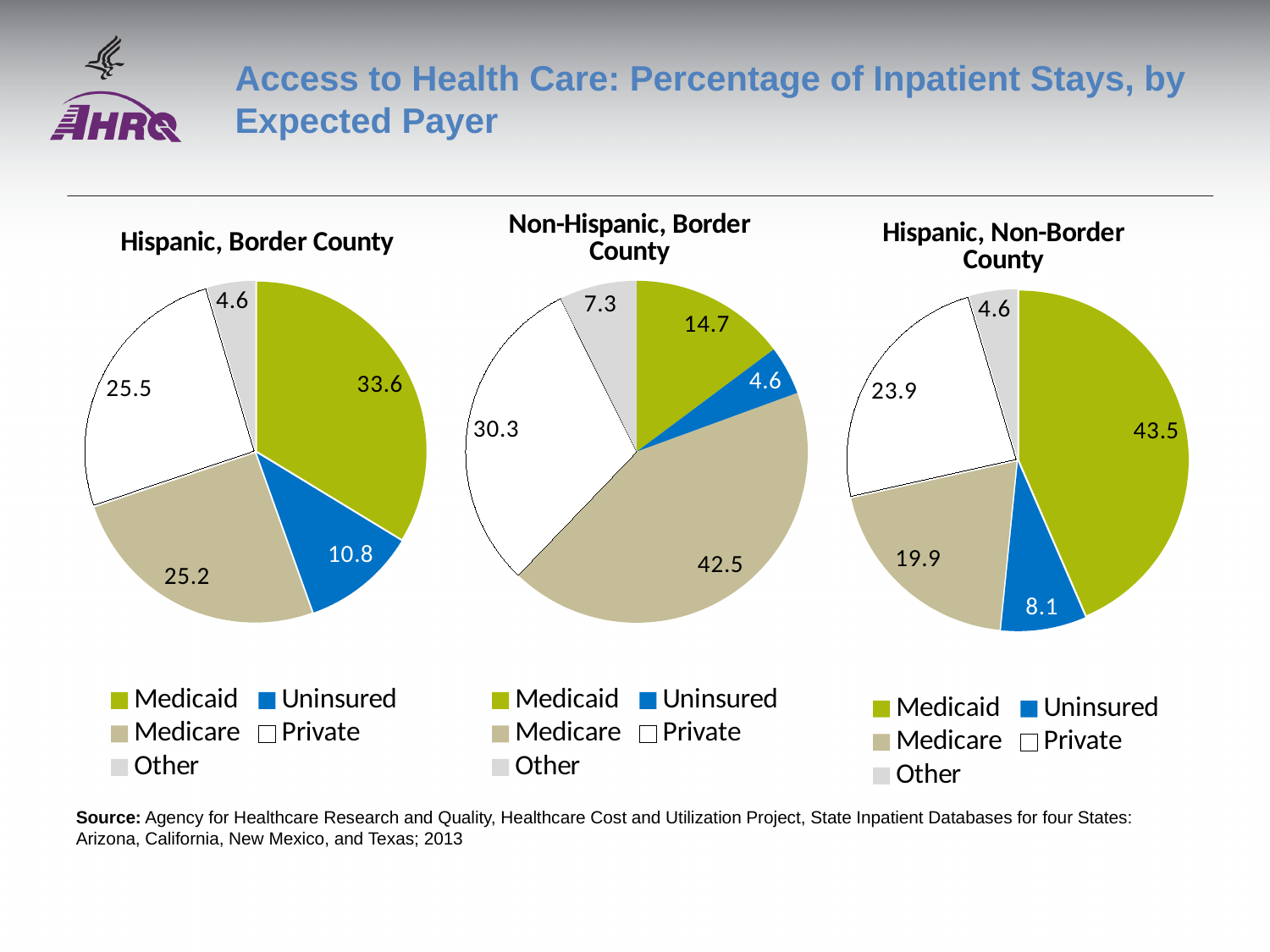
In the Hispanic, Non-Border County chart, what is the value for Uninsured? 8.1 In the Hispanic, Non-Border County chart, what is the difference between the Private and Medicare values? 4.0 In the Non-Hispanic, Border County chart, what is the value for Other? 7.3 How many payer categories does each pie chart show? 5 In the Hispanic, Border County chart, which payer has the smallest slice? Other In the Non-Hispanic, Border County chart, which is larger, Private or Medicaid? Private In the Hispanic, Border County chart, what is the difference between the Medicaid and Uninsured values? 22.8 In the Hispanic, Non-Border County chart, which payer has the largest slice? Medicaid In the Non-Hispanic, Border County chart, what is the value for Medicare? 42.5 What type of chart is used on this slide? Pie chart In the Hispanic, Border County chart, what is the value for Medicaid? 33.6 In the Non-Hispanic, Border County chart, which payer has the smallest slice? Uninsured